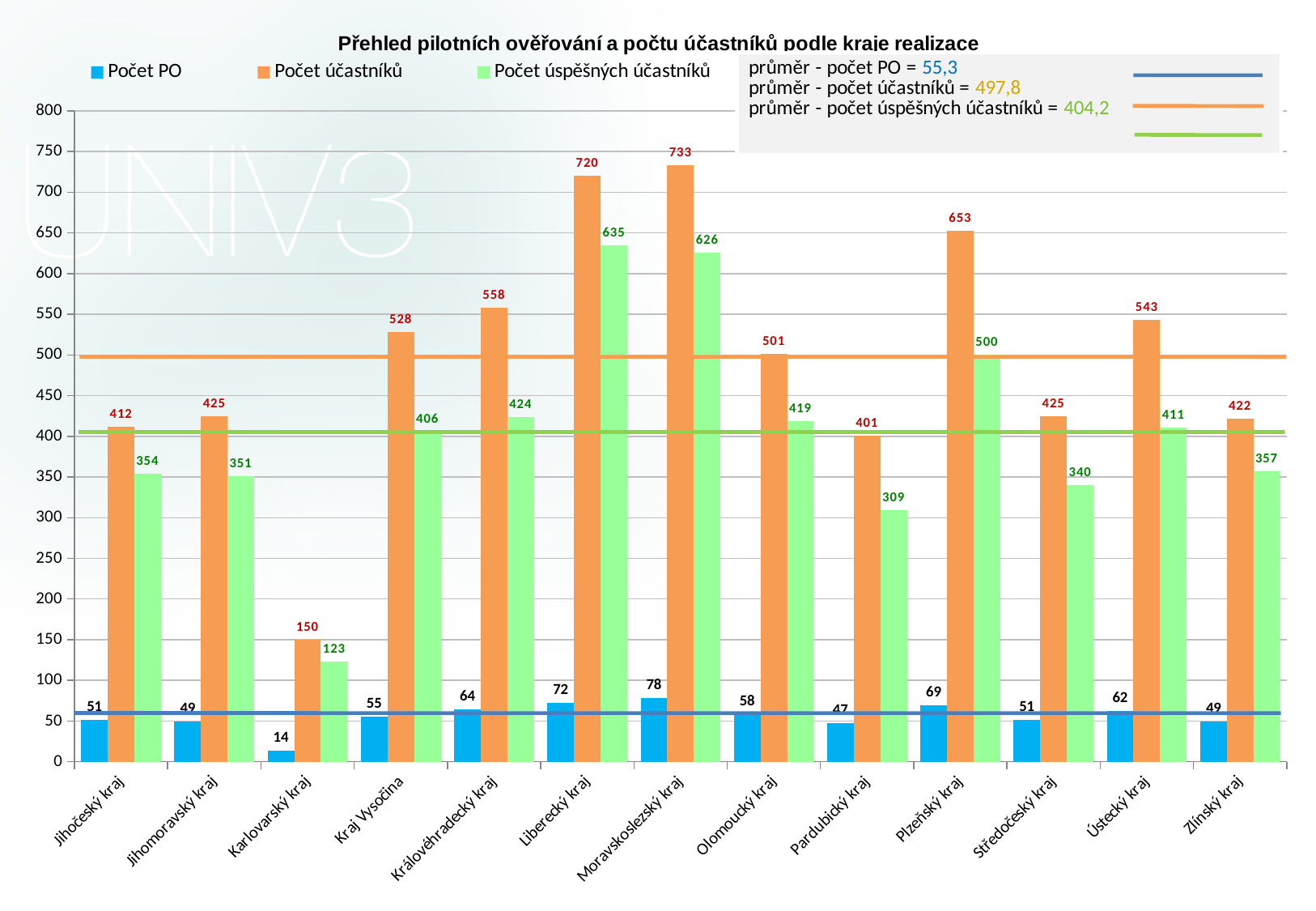
How many series does the legend at the top of the chart list? 3 What is the value of Počet úspěšných účastníků for Plzeňský kraj? 500 Which region has the highest Počet účastníků? Moravskoslezský kraj What is the difference between Počet účastníků and Počet úspěšných účastníků for Liberecký kraj? 85 Which region has the lowest Počet úspěšných účastníků? Karlovarský kraj What kind of chart is this? bar chart How many regions are shown on the x axis? 13 Which region has the highest Počet PO? Moravskoslezský kraj Which is larger: Počet účastníků for Plzeňský kraj or for Ústecký kraj? Plzeňský kraj What is the value of Počet účastníků for Moravskoslezský kraj? 733 What is the value of Počet PO for Karlovarský kraj? 14 What is the average Počet účastníků stated in the box on the chart? 497,8